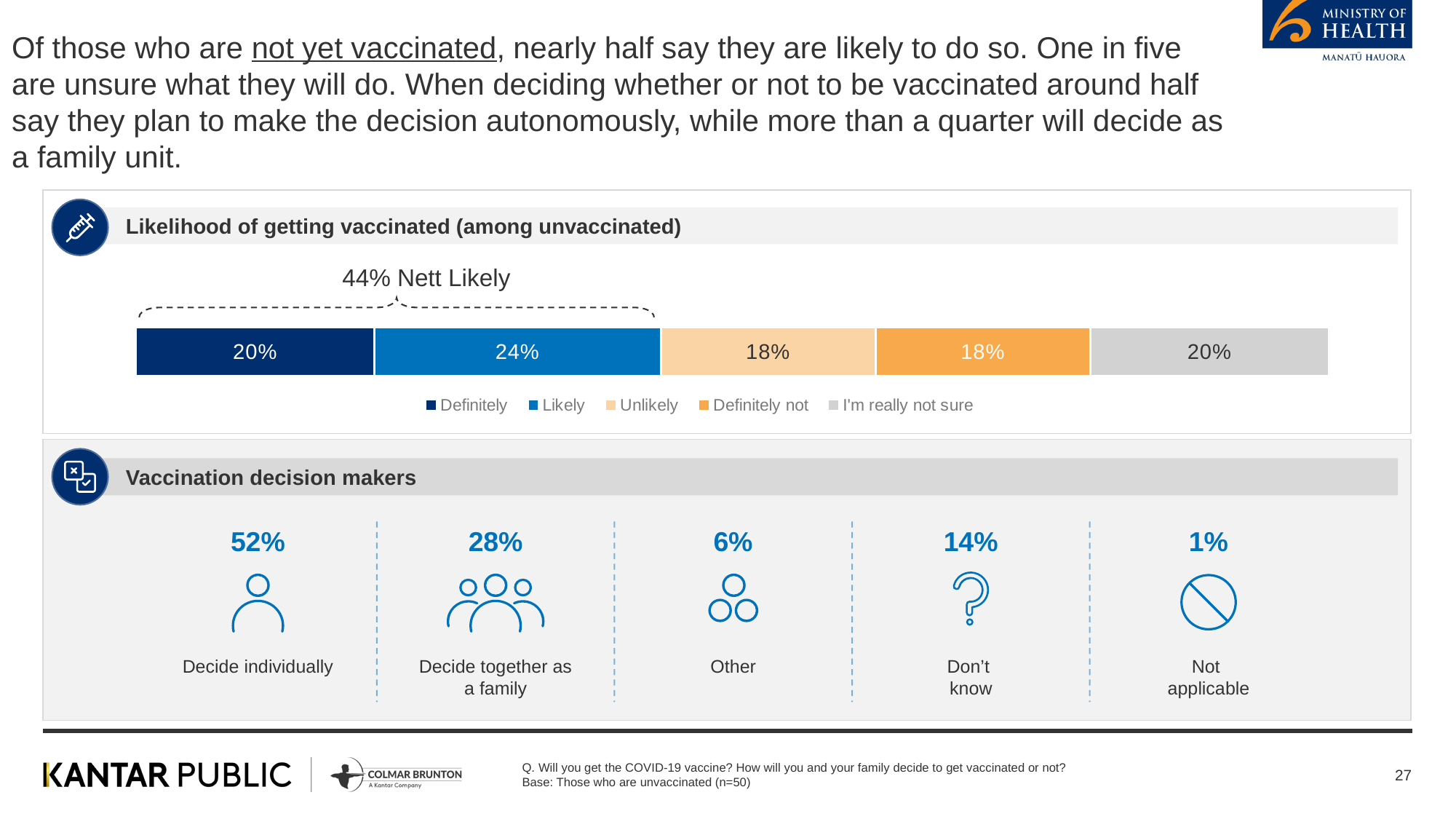
In the 'Vaccination decision makers' section, what percentage say they decide individually? 52% In the 'Likelihood of getting vaccinated (among unvaccinated)' chart, what percentage say 'Definitely not'? 18% In the 'Likelihood of getting vaccinated (among unvaccinated)' chart, what percentage say 'Likely'? 24% In the 'Likelihood of getting vaccinated (among unvaccinated)' chart, what is the combined 'Nett Likely' percentage shown above the bar? 44% In the 'Likelihood of getting vaccinated (among unvaccinated)' chart, which response has the largest share? Likely In the 'Likelihood of getting vaccinated (among unvaccinated)' chart, which legend entry is shown in grey? I'm really not sure In the 'Likelihood of getting vaccinated (among unvaccinated)' chart, what percentage say 'Definitely'? 20% In the 'Vaccination decision makers' section, what is the difference between 'Decide individually' and 'Decide together as a family'? 24% In the 'Likelihood of getting vaccinated (among unvaccinated)' chart, how many series does the legend list? 5 In the 'Likelihood of getting vaccinated (among unvaccinated)' chart, what is the difference between the 'Likely' and 'Unlikely' percentages? 6% What kind of chart is the 'Likelihood of getting vaccinated (among unvaccinated)' chart? Stacked bar chart In the 'Vaccination decision makers' section, which option has the lowest percentage? Not applicable